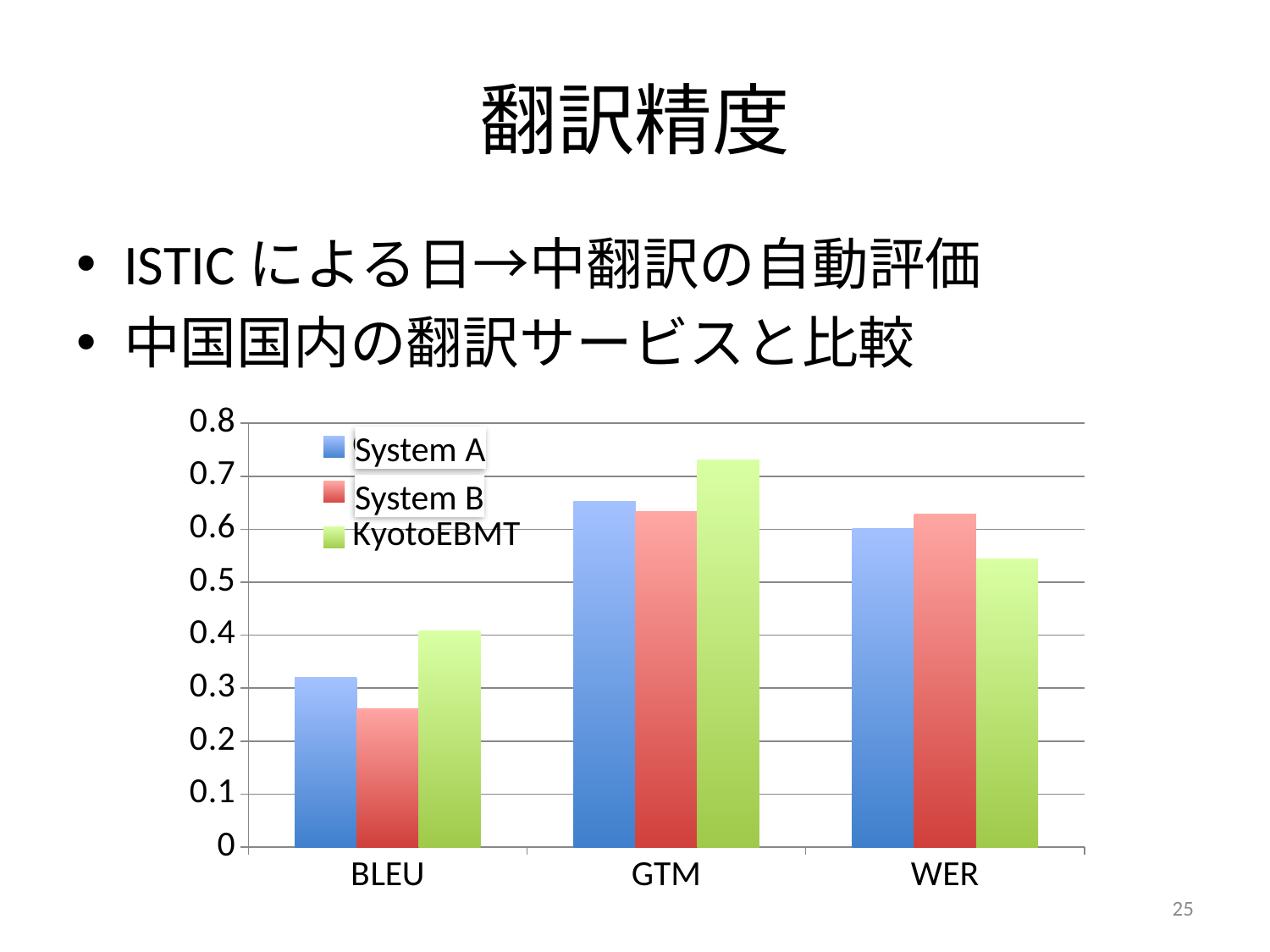
How many series does the legend list? 3 Is the value for System B on BLEU greater or less than 0.3? less Which series is shown in green in the legend? KyotoEBMT What kind of chart is shown on the slide? bar chart Which series has the highest value for BLEU? KyotoEBMT Which is larger for WER: System A or KyotoEBMT? System A Which series has the lowest value for WER? KyotoEBMT Which series has the highest value for GTM? KyotoEBMT Is the value for KyotoEBMT on GTM greater or less than 0.7? greater How many categories are shown on the x axis? 3 Which series has the lowest value for BLEU? System B